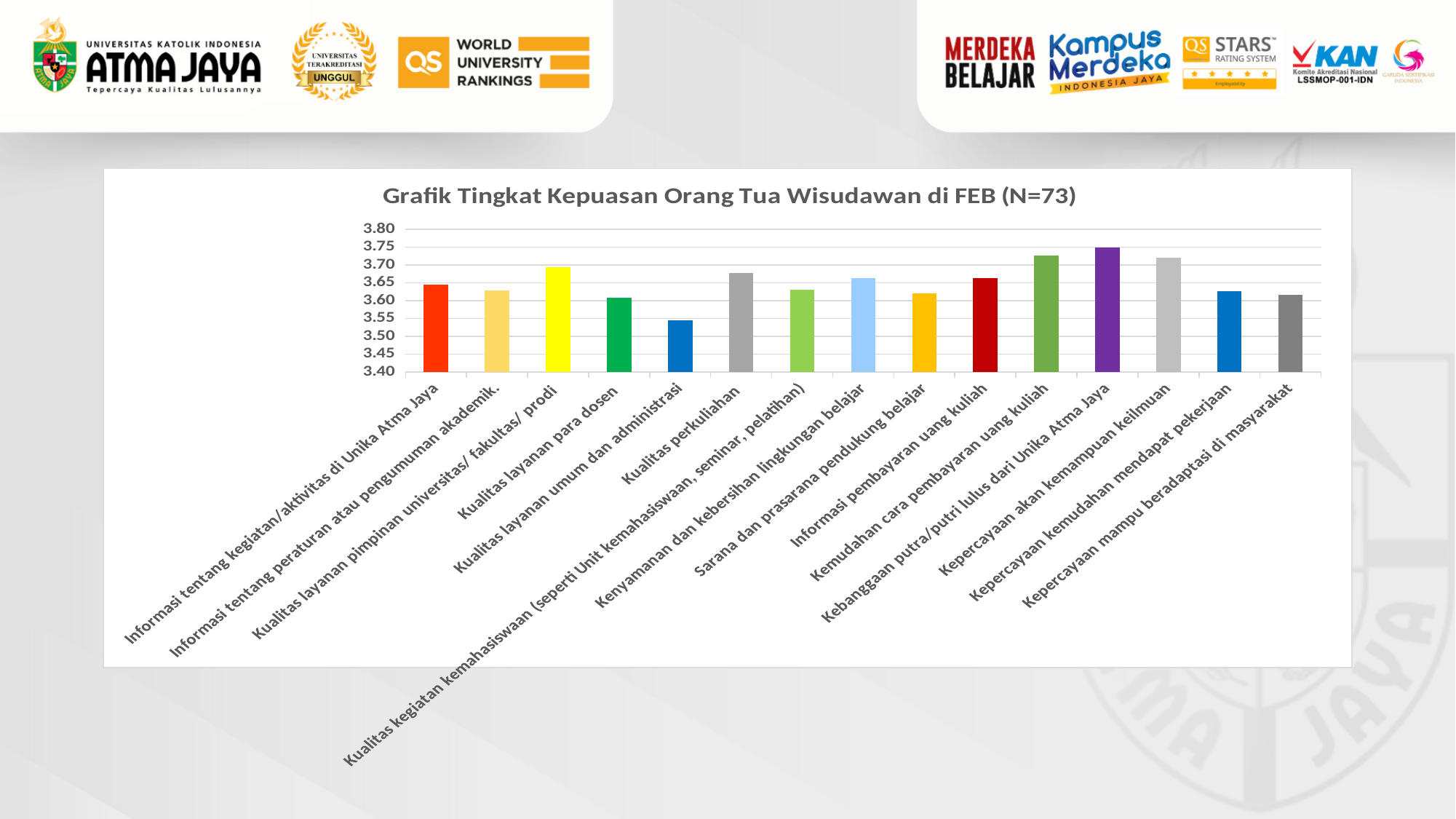
How many categories are plotted in the chart? 15 What is the sample size (N) stated in the chart title? 73 Is the value for Kualitas layanan para dosen greater or less than 3.65? less Is the value for Kualitas perkuliahan greater or less than 3.65? greater What is the title of the chart? Grafik Tingkat Kepuasan Orang Tua Wisudawan di FEB (N=73) Is the value for Kualitas layanan umum dan administrasi greater or less than 3.60? less Which is larger: the value for Kemudahan cara pembayaran uang kuliah or the value for Kualitas layanan para dosen? Kemudahan cara pembayaran uang kuliah Which category has the highest value in the chart? Kebanggaan putra/putri lulus dari Unika Atma Jaya Which category has the lowest value in the chart? Kualitas layanan umum dan administrasi What kind of chart is shown on the slide? bar chart Which is larger: the value for Kualitas perkuliahan or the value for Sarana dan prasarana pendukung belajar? Kualitas perkuliahan